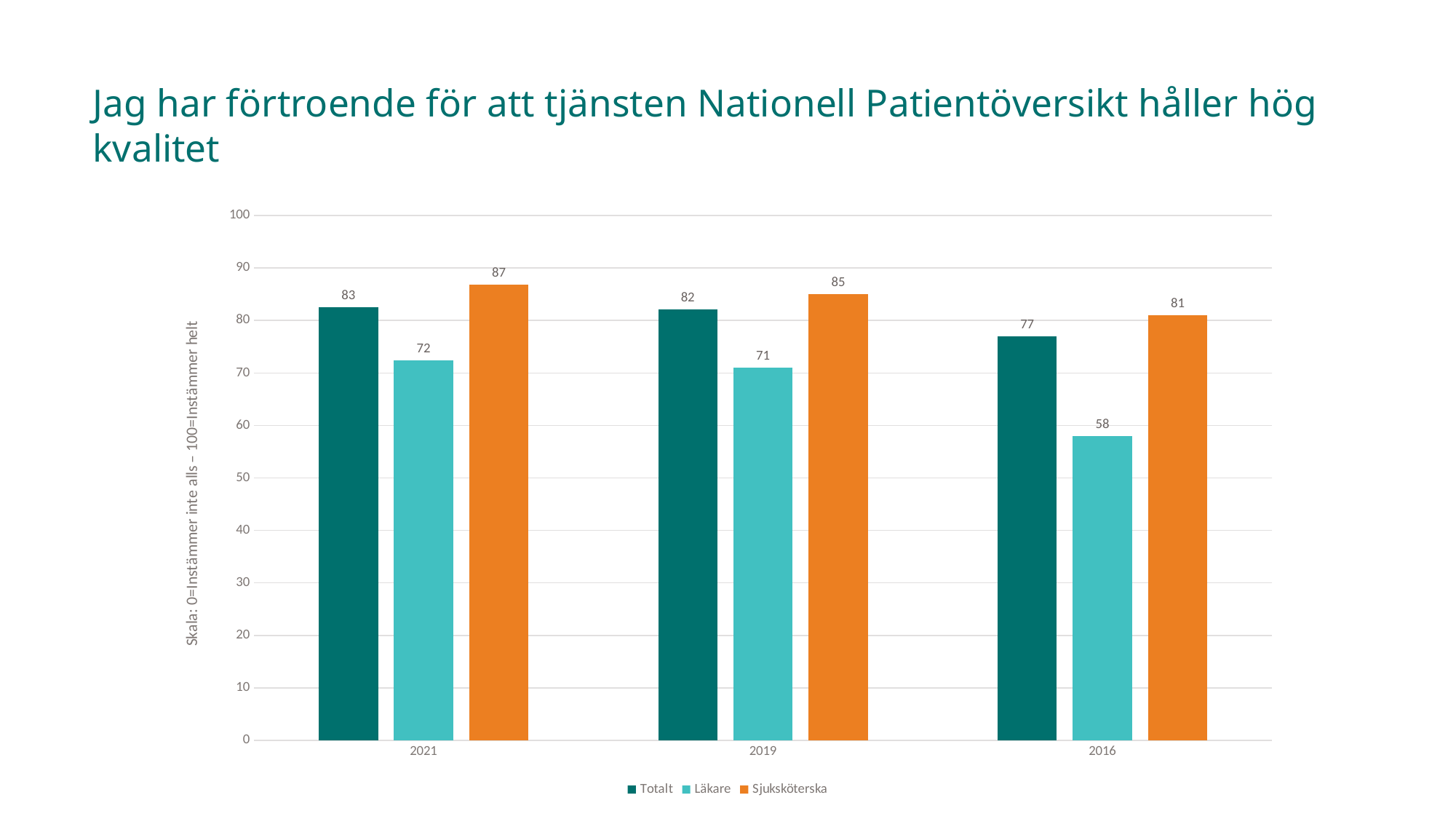
Which is larger in 2019: the value for Totalt or the value for Läkare? Totalt Which series is shown in orange in the legend? Sjuksköterska Is the value for Läkare in 2016 greater or less than 60? less What is the value for Sjuksköterska in 2019? 85 What kind of chart is shown on the slide? bar chart What is the value for Läkare in 2016? 58 How many years are shown on the x axis? 3 Which year has the lowest value for Läkare? 2016 What is the difference between the Sjuksköterska and Läkare values in 2016? 23 How many series does the legend list? 3 Which year has the highest value for Sjuksköterska? 2021 What is the value for Totalt in 2021? 83